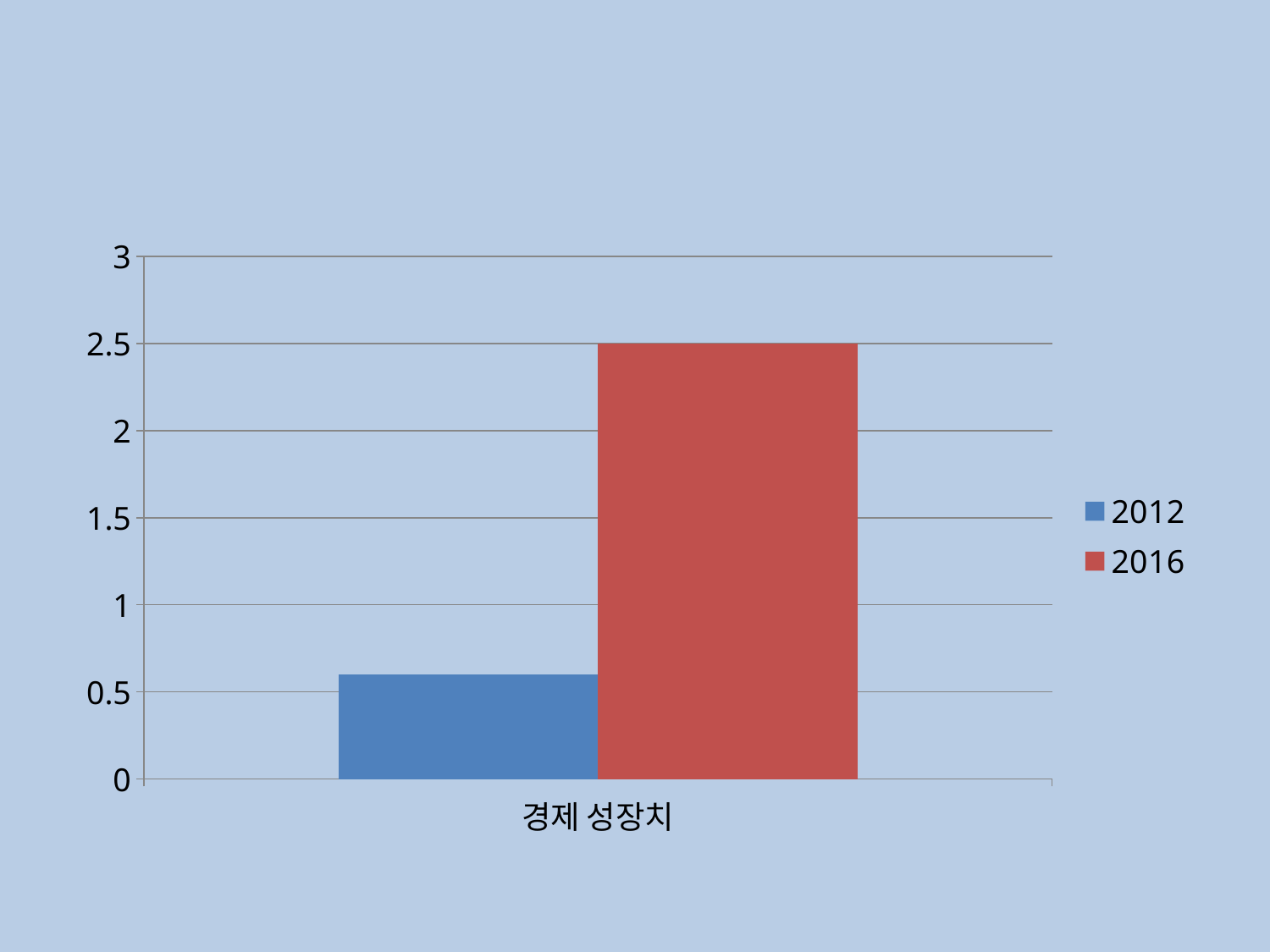
Is the value of the 2012 bar for 경제 성장치 greater or less than 0.5? greater How many series does the legend list? 2 How many categories are shown on the x axis? 1 What is the category label shown on the x axis? 경제 성장치 What kind of chart is shown on the slide? bar chart Which series has the lowest bar in the chart? 2012 Which series has the larger value for 경제 성장치, 2012 or 2016? 2016 Which series has the highest bar in the chart? 2016 What colour is the bar for the 2016 series? red What is the value of the 2016 bar for 경제 성장치? 2.5 Is the value of the 2012 bar for 경제 성장치 greater or less than 1? less Does the value for 경제 성장치 rise or fall from 2012 to 2016? rise